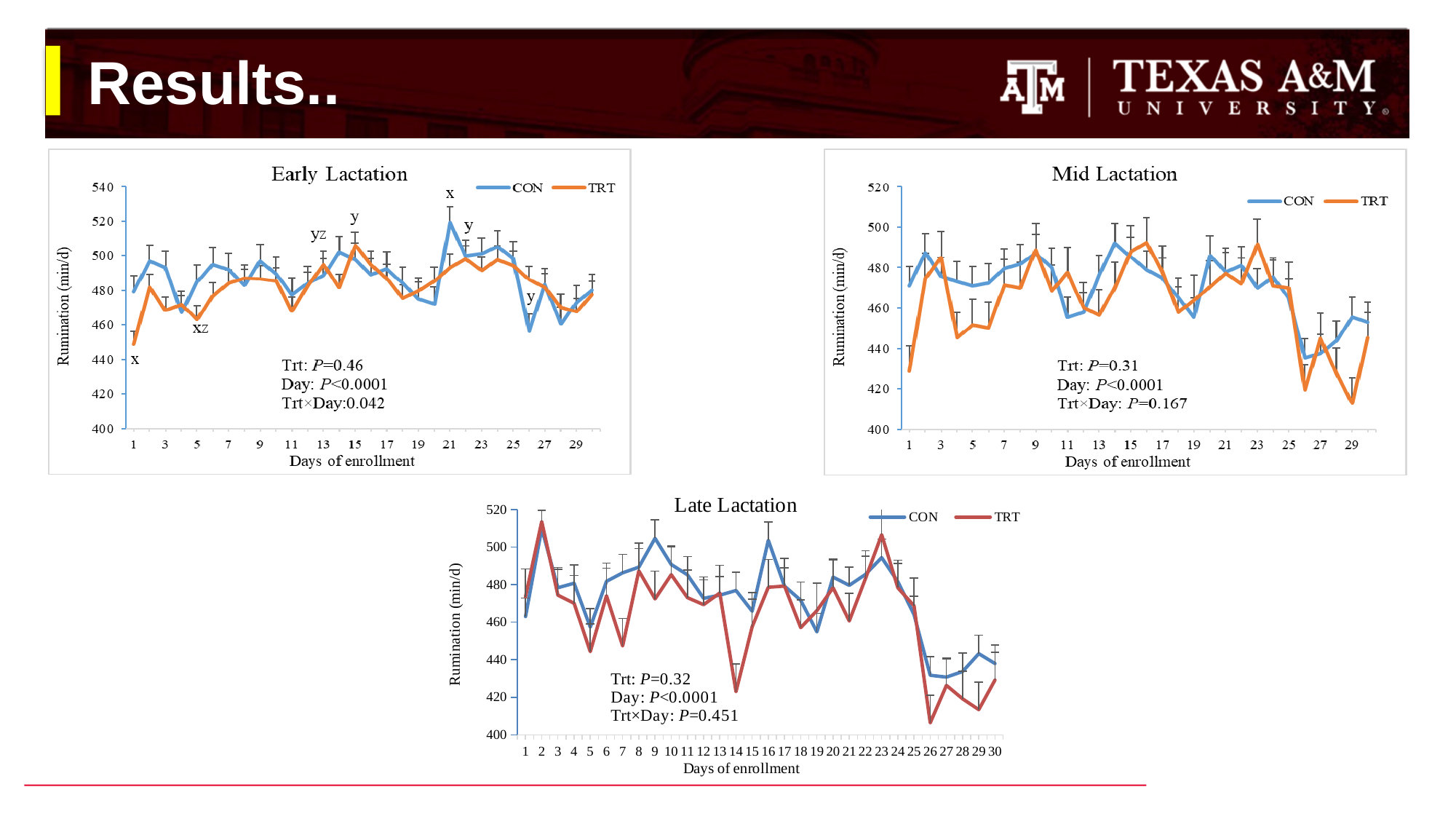
In the Early Lactation chart, is the CON value on day 21 greater or less than 500? greater What kind of chart is the Early Lactation chart? line chart In the Early Lactation chart, which series has the larger value on day 1, CON or TRT? CON In the Early Lactation chart, is the TRT value on day 1 greater or less than 460? less In the Mid Lactation chart, is the CON value on day 14 greater or less than 480? greater How many series does the legend of the Mid Lactation chart list? 2 In the Late Lactation chart, how many days of enrollment are shown on the x axis? 30 In the Late Lactation chart, which series has the larger value on day 14, CON or TRT? CON What is the y-axis label of the Mid Lactation chart? Rumination (min/d) What are the two legend entries in the Late Lactation chart? CON and TRT